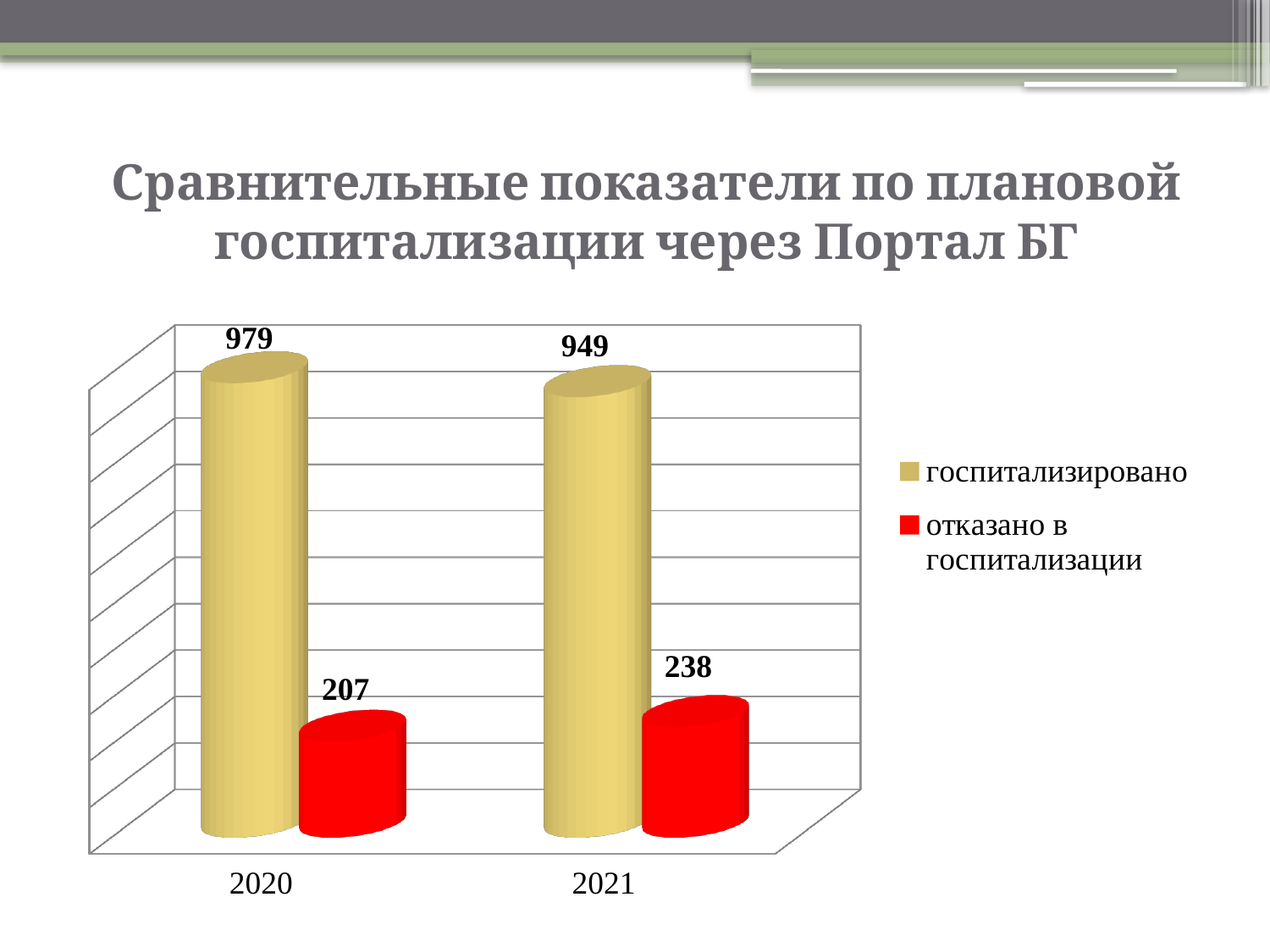
What is the value for "госпитализировано" in 2021? 949 What is the value for "госпитализировано" in 2020? 979 What is the value for "отказано в госпитализации" in 2021? 238 What is the difference between the "отказано в госпитализации" values for 2021 and 2020? 31 What kind of chart is shown on the slide? bar chart What is the difference between the "госпитализировано" values for 2020 and 2021? 30 How many series does the legend list? 2 Which year has the higher value for "госпитализировано"? 2020 What is the value for "отказано в госпитализации" in 2020? 207 Is the value for "госпитализировано" in 2021 larger or smaller than the value for "отказано в госпитализации" in 2021? larger Which year has the lower value for "отказано в госпитализации"? 2020 How many years are shown on the x axis? 2